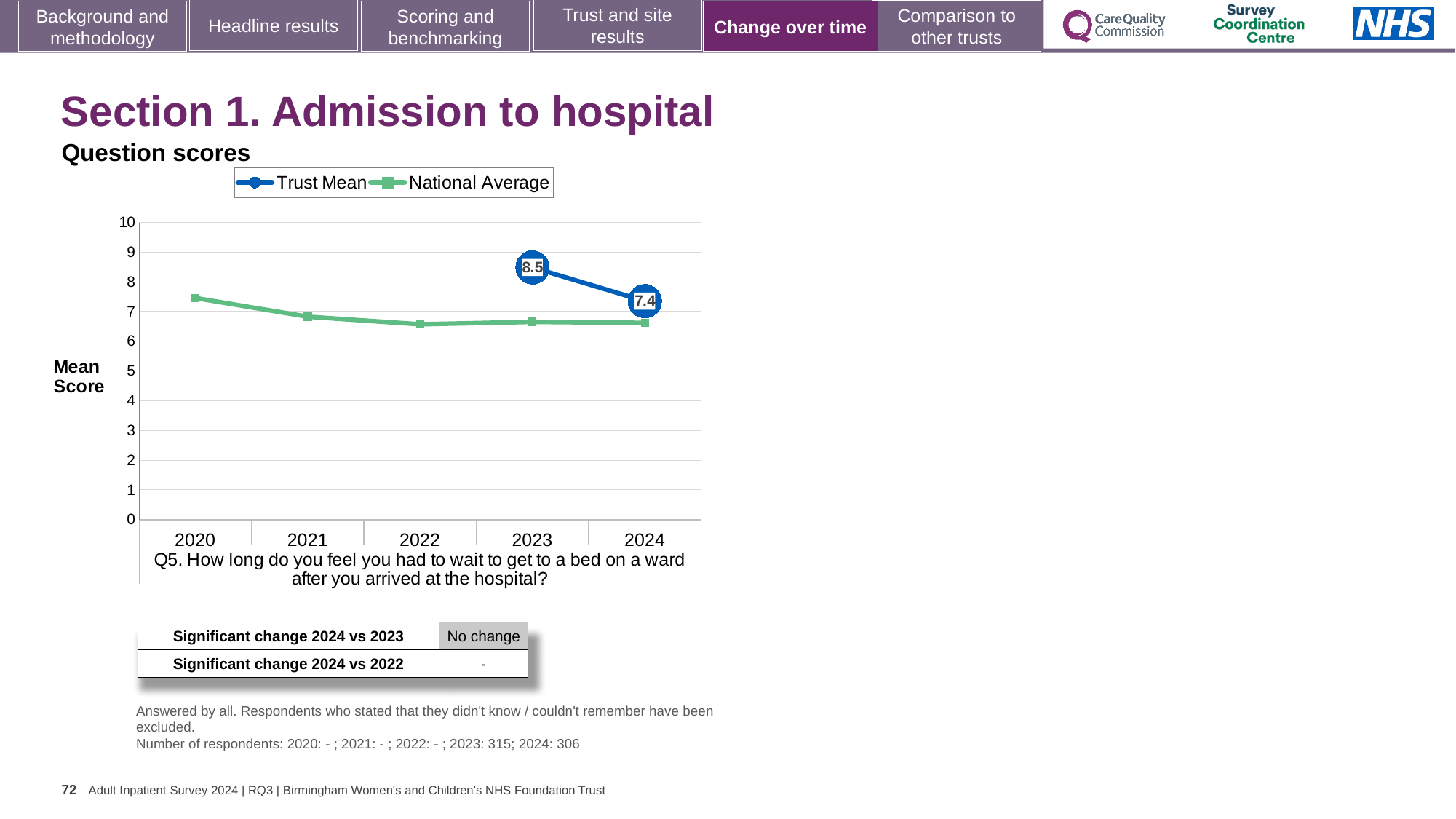
What kind of chart is shown on the slide? line chart How many series does the legend list? 2 What is the difference between the Trust Mean in 2023 and in 2024? 1.1 How many years are shown on the x axis? 5 What are the two series named in the legend? Trust Mean and National Average Is the National Average value for 2022 greater or less than 7? less Is the National Average value for 2020 greater or less than 7? greater What is the Trust Mean value for 2023? 8.5 In 2024, which is larger, the Trust Mean or the National Average? Trust Mean What is the Trust Mean value for 2024? 7.4 Does the Trust Mean rise or fall from 2023 to 2024? fall Which year has the higher Trust Mean, 2023 or 2024? 2023